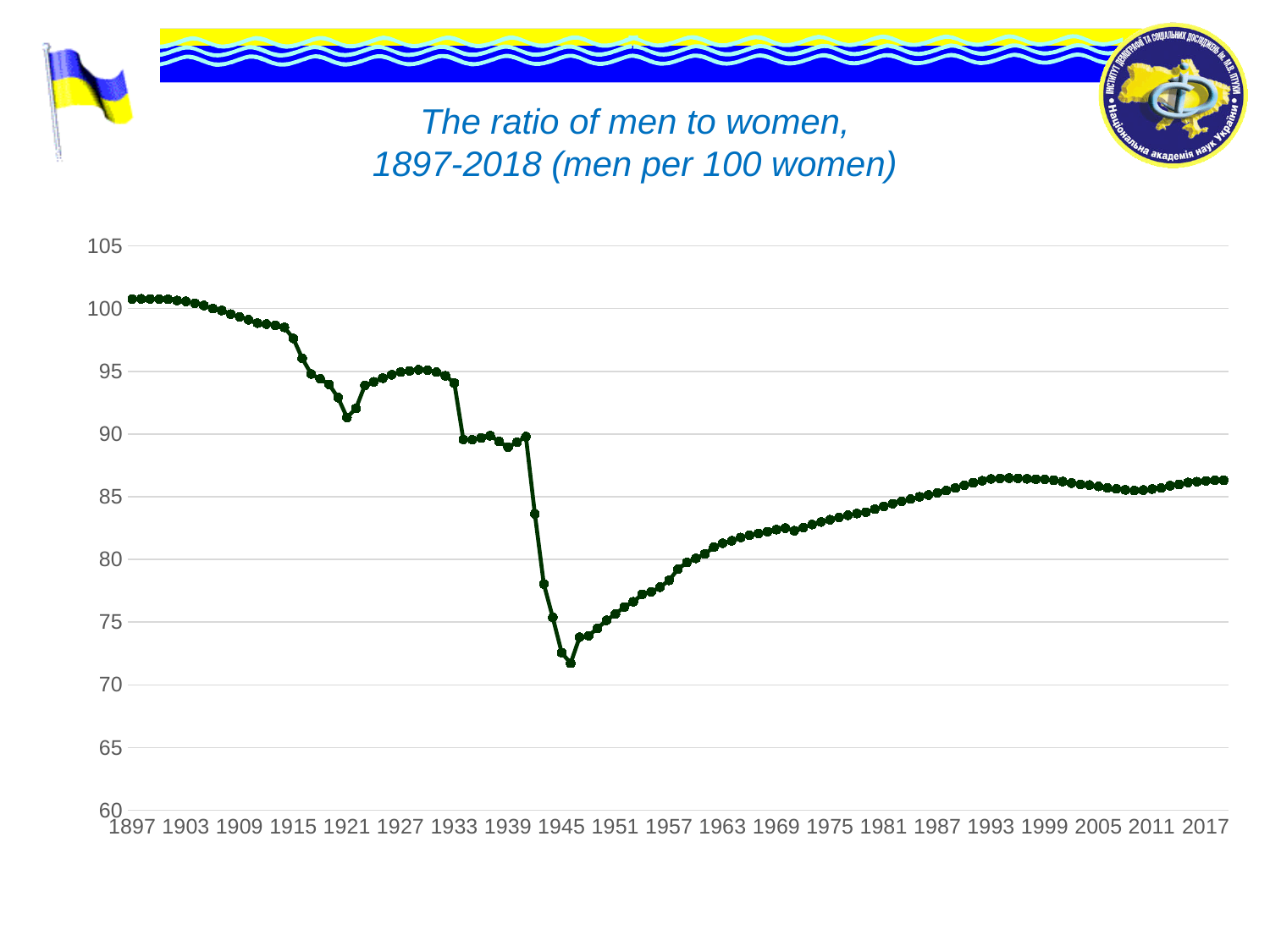
Which year has the larger value, 1957 or 1993? 1993 Is the value for 1963 greater or less than 80? greater Is the value for 1921 greater or less than 95? less What kind of chart is shown on the slide? line chart Which year has the larger value, 1927 or 1945? 1927 Does the ratio rise or fall between 1945 and 1993? rise Is the value for 1951 greater or less than 80? less Which year has the larger value, 1897 or 2017? 1897 What is the title of the chart? The ratio of men to women, 1897-2018 (men per 100 women)